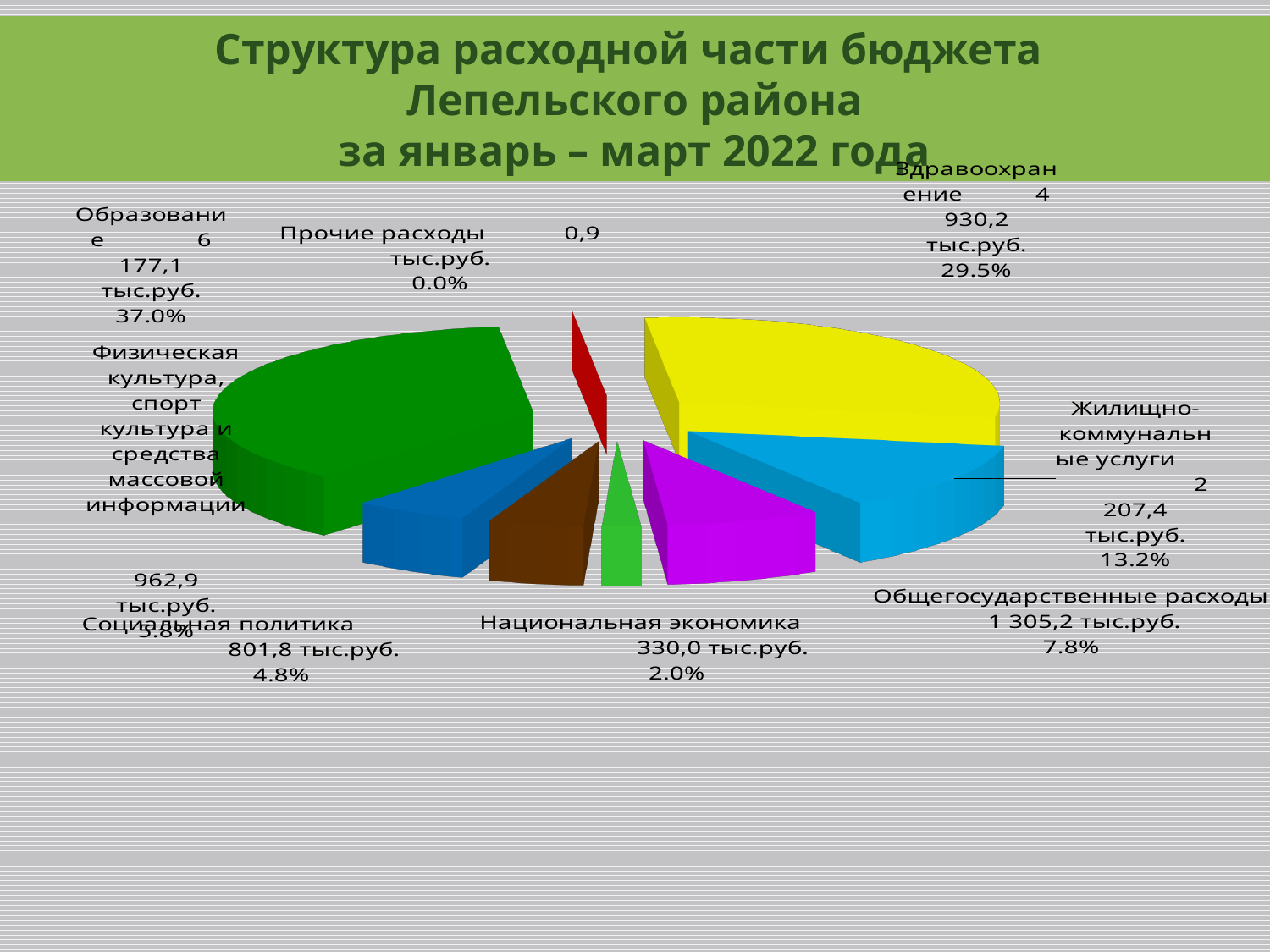
What percentage share does Жилищно-коммунальные услуги have? 13.2% Which is larger: the value for Социальная политика or the value for Национальная экономика? Социальная политика What is the difference in percentage points between the shares of Образование and Здравоохранение? 7.5 Which category has the largest share of the expenditure? Образование Which category has the smallest share of the expenditure? Прочие расходы What share of the budget expenditure does Образование account for? 37.0% What is the value for Здравоохранение in тыс.руб.? 4 930,2 тыс.руб. What is the value for Общегосударственные расходы? 1 305,2 тыс.руб. What kind of chart is shown on the slide? pie chart What is the value for Физическая культура, спорт, культура и средства массовой информации? 962,9 тыс.руб. What is the title of the chart on the slide? Структура расходной части бюджета Лепельского района за январь – март 2022 года How many categories (slices) does the pie chart show? 8